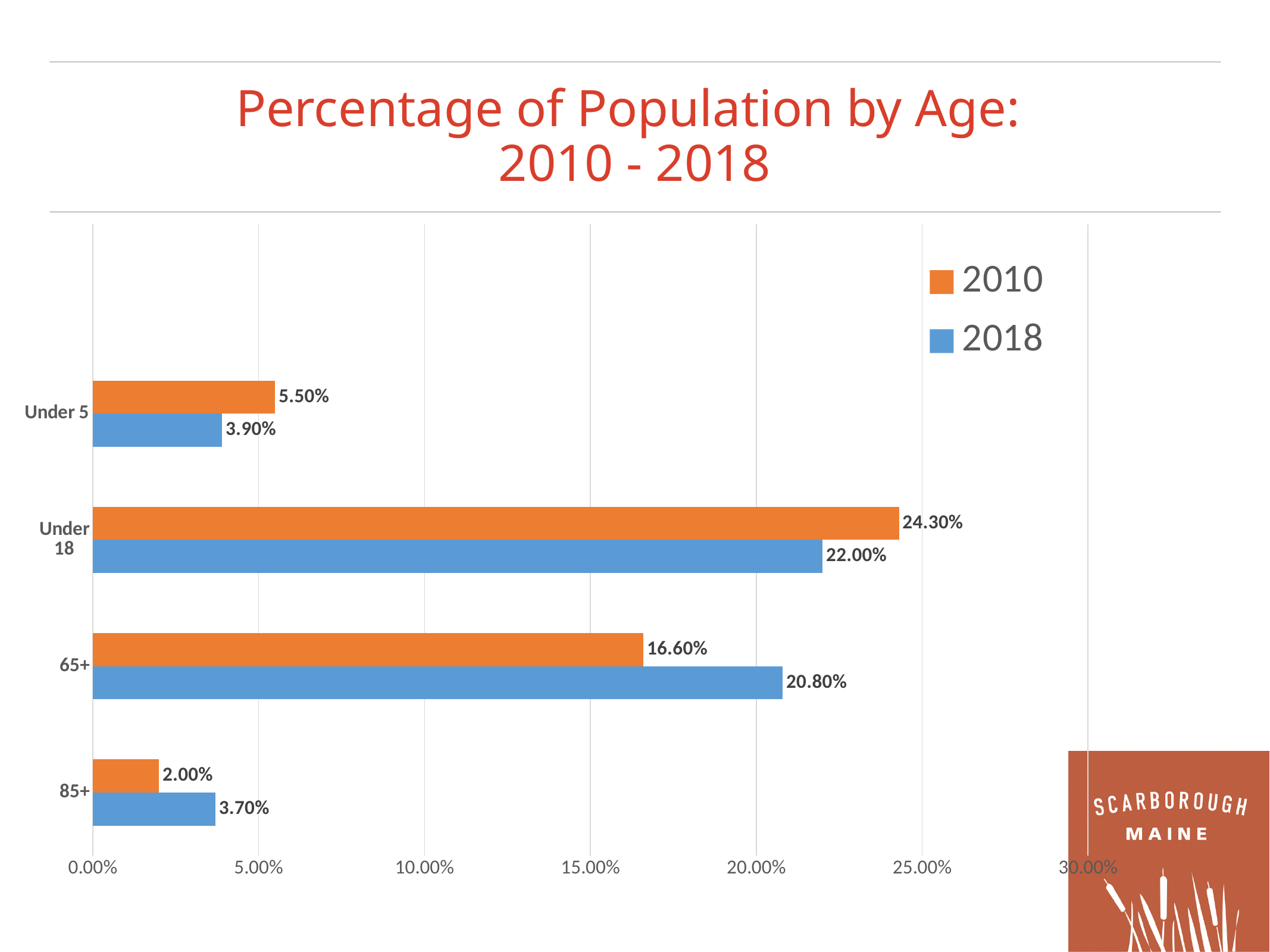
For the 65+ age group, which year has the larger value, 2010 or 2018? 2018 What kind of chart is shown on the slide? Bar chart Which age group had the highest percentage of population in 2010? Under 18 Is the 2018 value for Under 18 greater or less than 20.00%? greater Which age group had the lowest percentage of population in 2018? 85+ What was the percentage of population Under 5 in 2010? 5.50% What is the difference between the 2010 and 2018 values for the Under 18 age group? 2.30% How many series does the legend list? 2 How many age groups are shown in the chart? 4 Which colour represents the 2018 series in the chart? Blue What was the percentage of population aged 85+ in 2010? 2.00% What was the percentage of population aged 65+ in 2018? 20.80%